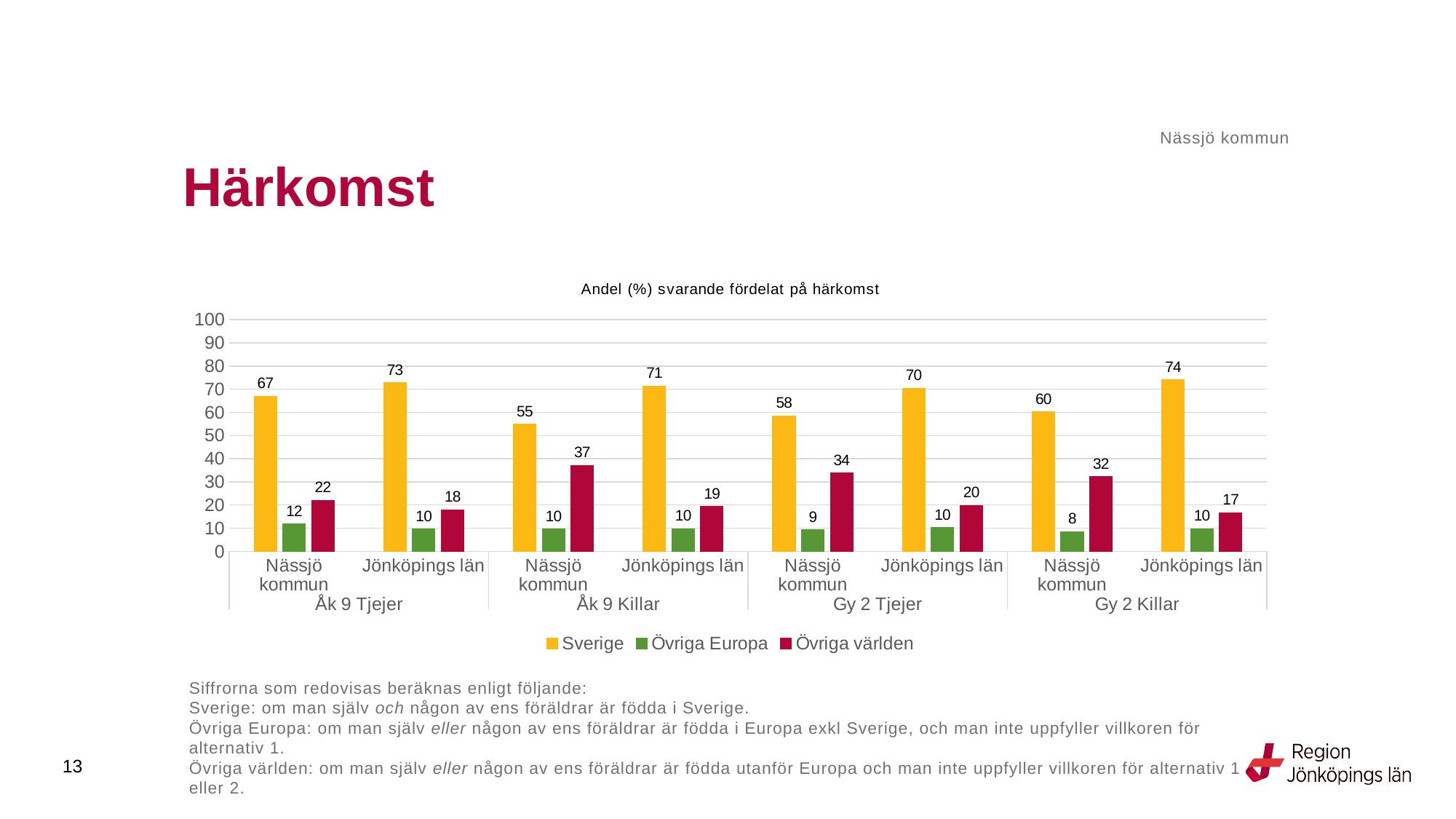
What is the value for Sverige for Nässjö kommun in the Åk 9 Tjejer group? 67 Which colour represents Övriga Europa in the chart? green Which group and area has the lowest Sverige value? Nässjö kommun, Åk 9 Killar What is the value for Övriga Europa for Nässjö kommun in the Gy 2 Killar group? 8 Is the Sverige value for Nässjö kommun in the Gy 2 Killar group greater or less than 50? greater How many series does the legend list? 3 What is the title of the chart? Andel (%) svarande fördelat på härkomst What is the difference between the Sverige values for Jönköpings län and Nässjö kommun in the Gy 2 Tjejer group? 12 What kind of chart is shown on the slide? bar chart Which group and area has the highest Sverige value? Jönköpings län, Gy 2 Killar Which is larger: Övriga världen for Nässjö kommun in Gy 2 Tjejer or in Gy 2 Killar? Gy 2 Tjejer What is the value for Övriga världen for Nässjö kommun in the Åk 9 Killar group? 37